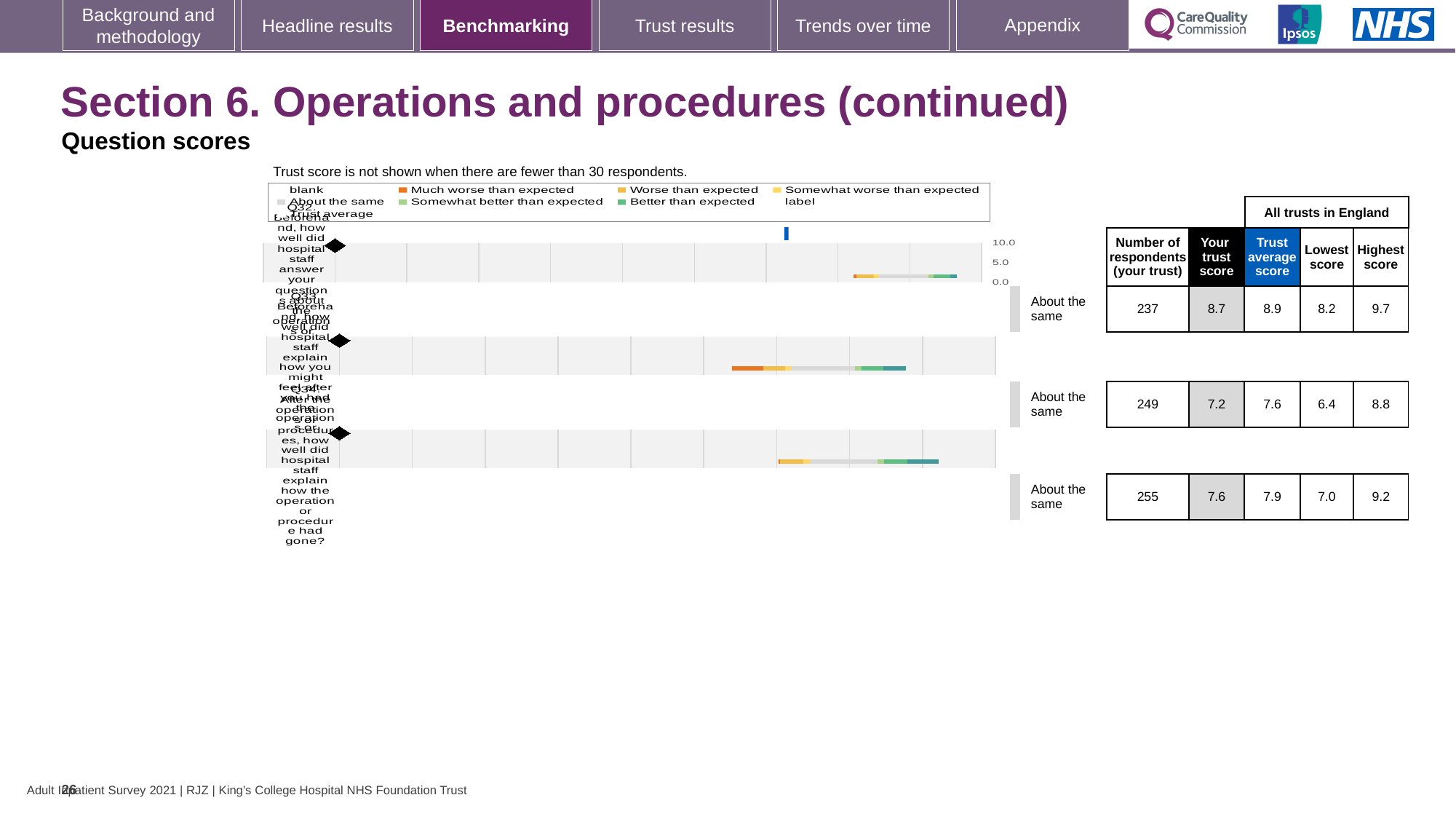
For the second chart on the slide, what is the trust average score for all trusts in England? 7.6 For the top chart on the slide, how many respondents does the table show for the trust? 237 Which of the three charts on the slide has the highest 'Your trust score'? The top chart How many benchmarking charts are shown on the slide? 3 For the second chart on the slide, is your trust score larger or smaller than the trust average score? Smaller For the third chart on the slide, what is the highest score among all trusts in England? 9.2 For the third chart on the slide, what is the difference between the trust average score and your trust score? 0.3 For the second chart on the slide, what is the lowest score among all trusts in England? 6.4 For the top chart on the slide, what is the trust score shown in the 'Your trust score' column? 8.7 Which of the three charts on the slide has the lowest number of respondents? The top chart What benchmark category label is shown next to each of the three charts? About the same For the top chart on the slide, what is the difference between the highest score and the lowest score? 1.5